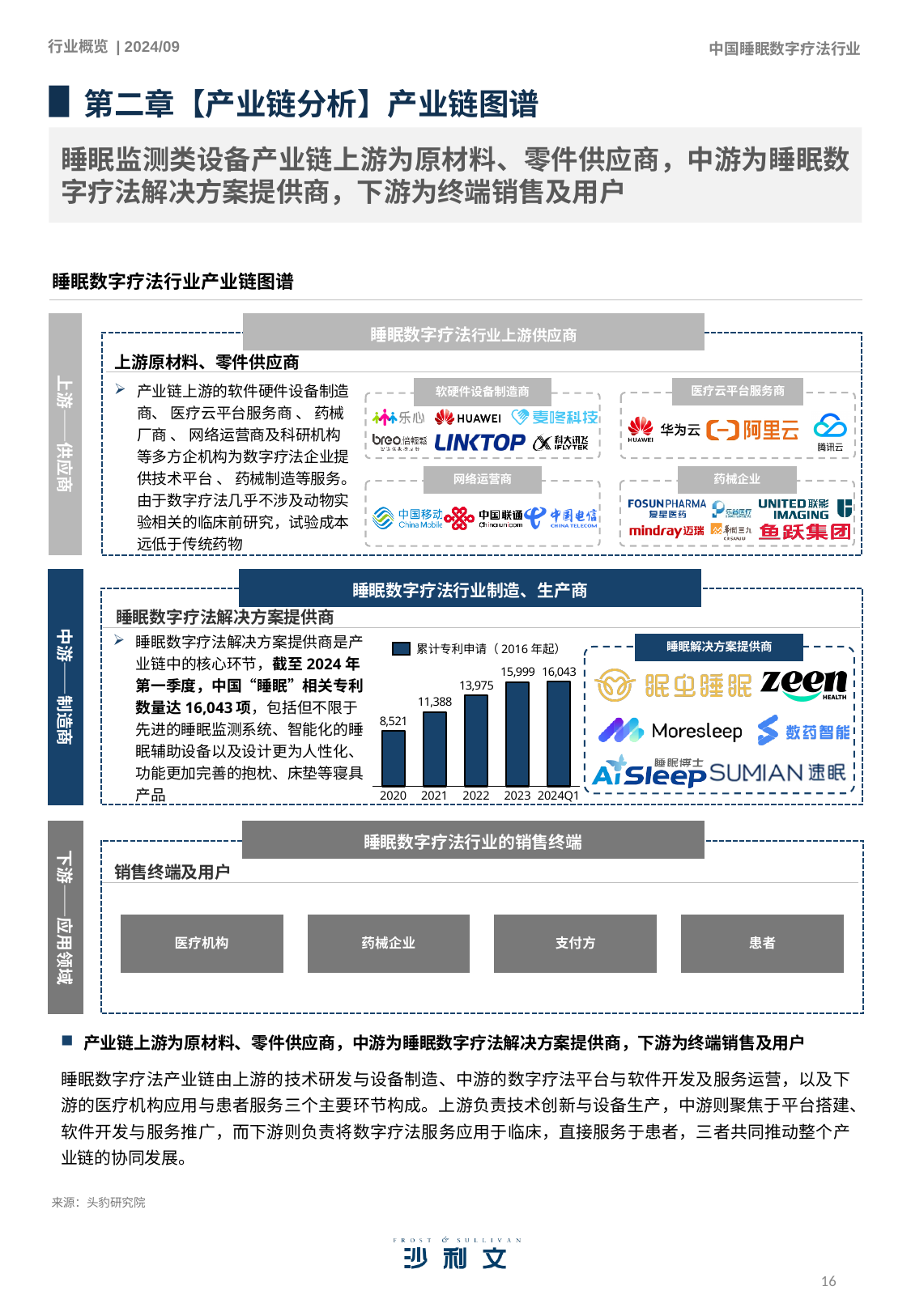
What is the cumulative patent application value shown for 2024Q1? 16,043 What is the difference between the cumulative patent application values for 2023 and 2022? 2,024 What kind of chart is used to show the cumulative patent applications? bar chart Which is larger, the cumulative patent application value for 2021 or for 2022? 2022 What is the cumulative patent application value shown for 2020? 8,521 Which x-axis category has the highest cumulative patent application value? 2024Q1 What is the cumulative patent application value shown for 2022? 13,975 Do the cumulative patent application values rise or fall from 2020 to 2024Q1? rise What is the difference between the cumulative patent application values for 2021 and 2020? 2,867 How many bars are plotted in the cumulative patent application chart? 5 How many series does the legend of the patent chart list? 1 Which year on the x axis has the lowest cumulative patent application value? 2020